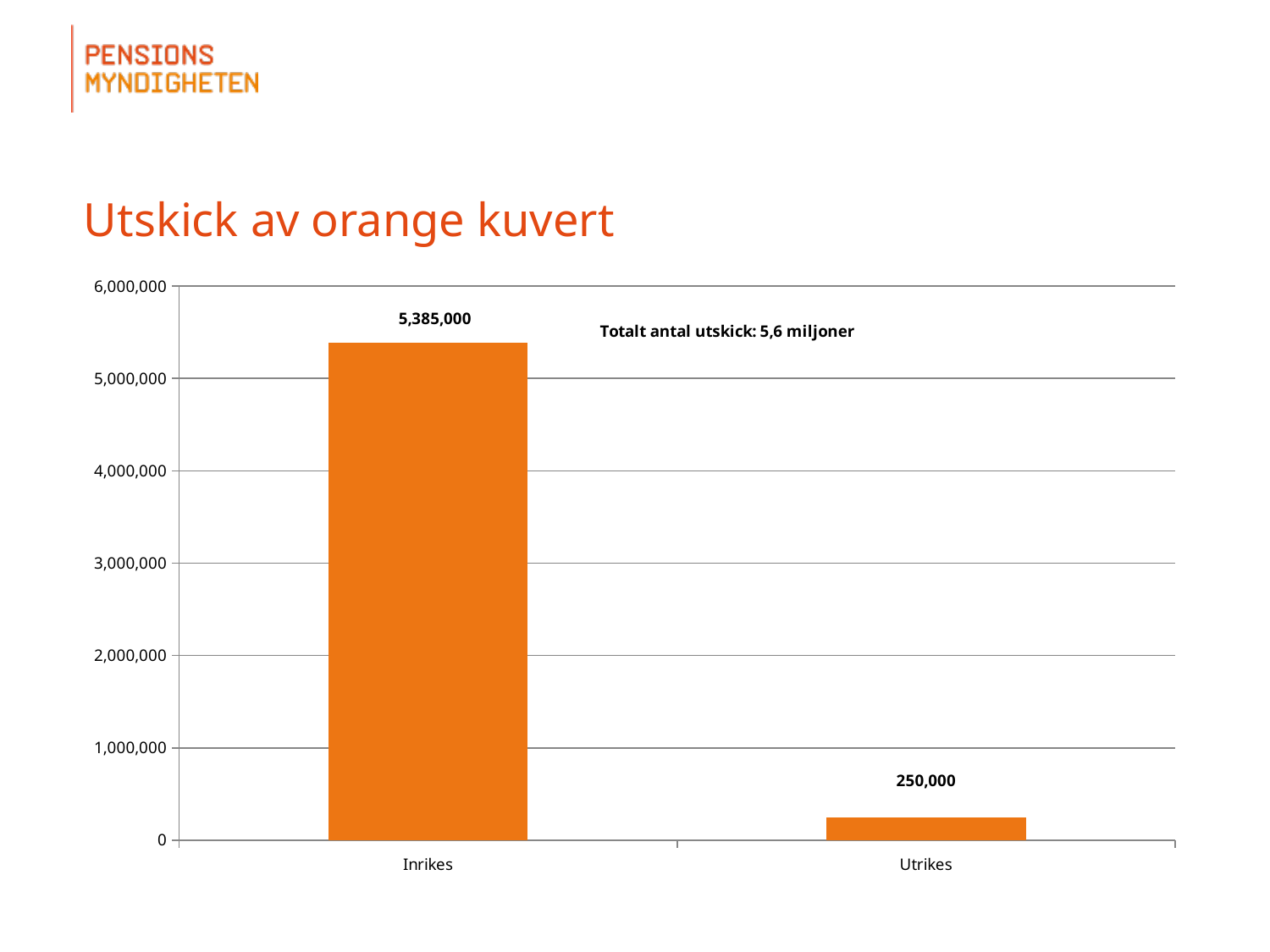
Which category has the lowest value? Utrikes Is the value for Inrikes greater or less than 5,000,000? greater What is the title of the slide above the chart? Utskick av orange kuvert What is the difference between the values for Inrikes and Utrikes? 5,135,000 What is the value for Inrikes? 5,385,000 What kind of chart is shown on the slide? bar chart What total number of mailings does the text annotation inside the chart state? 5,6 miljoner Which category has the highest value? Inrikes What is the value for Utrikes? 250,000 How many categories are shown on the x axis? 2 Is the value for Utrikes greater or less than 1,000,000? less Which is larger, the value for Inrikes or the value for Utrikes? Inrikes